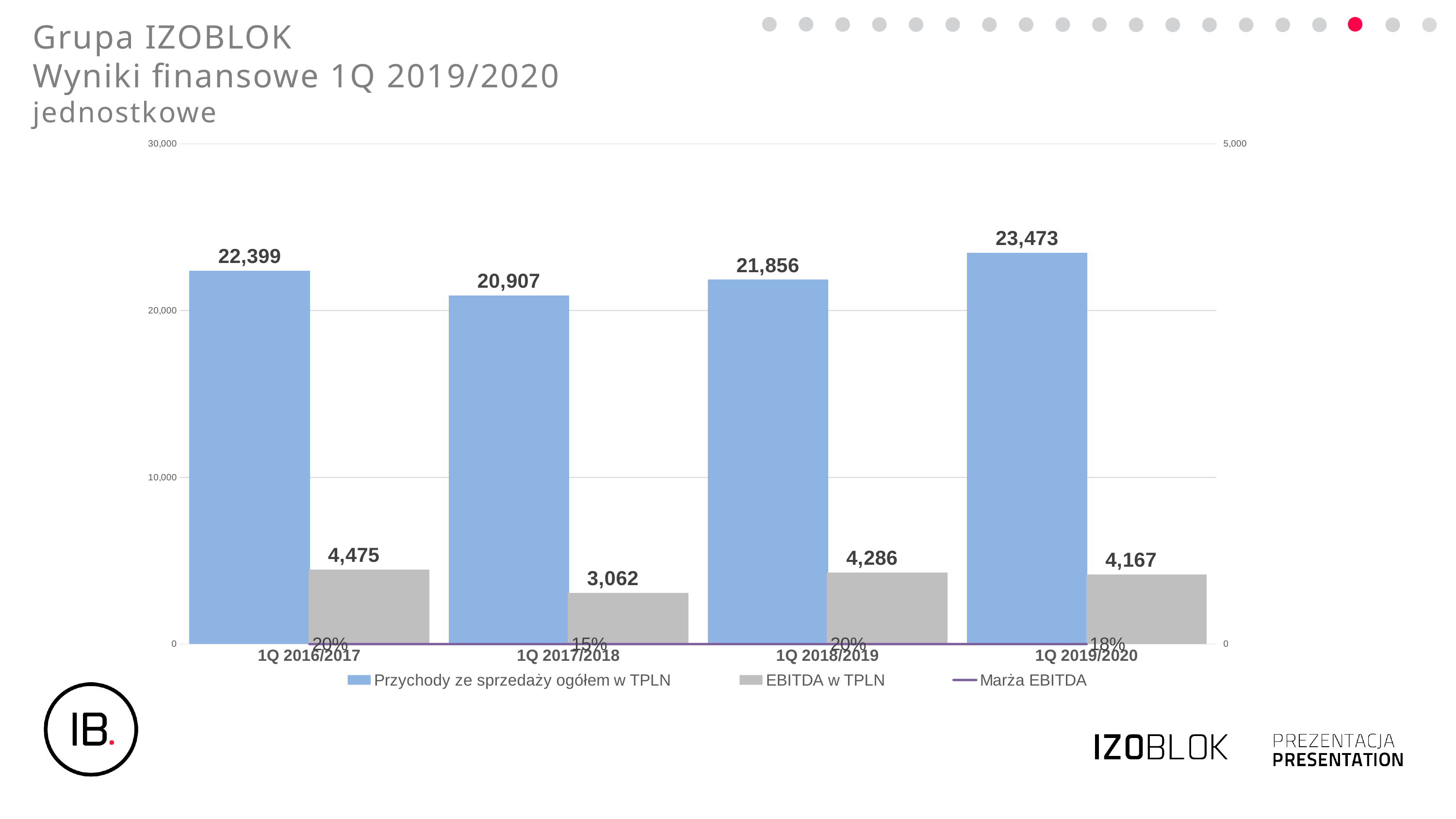
What is the difference between EBITDA w TPLN in 1Q 2016/2017 and 1Q 2019/2020? 308 What is the EBITDA w TPLN value for 1Q 2017/2018? 3,062 What is the value of Przychody ze sprzedaży ogółem w TPLN for 1Q 2019/2020? 23,473 What kind of chart is used to show Przychody ze sprzedaży ogółem w TPLN and EBITDA w TPLN? Bar chart How many series does the legend list? 3 Which series is shown in grey in the legend? EBITDA w TPLN Which period has the highest Przychody ze sprzedaży ogółem w TPLN? 1Q 2019/2020 How many periods are shown on the x axis? 4 Which period has the lowest EBITDA w TPLN? 1Q 2017/2018 Which is larger: Przychody ze sprzedaży ogółem w TPLN in 1Q 2016/2017 or in 1Q 2017/2018? 1Q 2016/2017 What is the Marża EBITDA for 1Q 2016/2017? 20% What is the difference between Przychody ze sprzedaży ogółem w TPLN in 1Q 2019/2020 and 1Q 2018/2019? 1,617